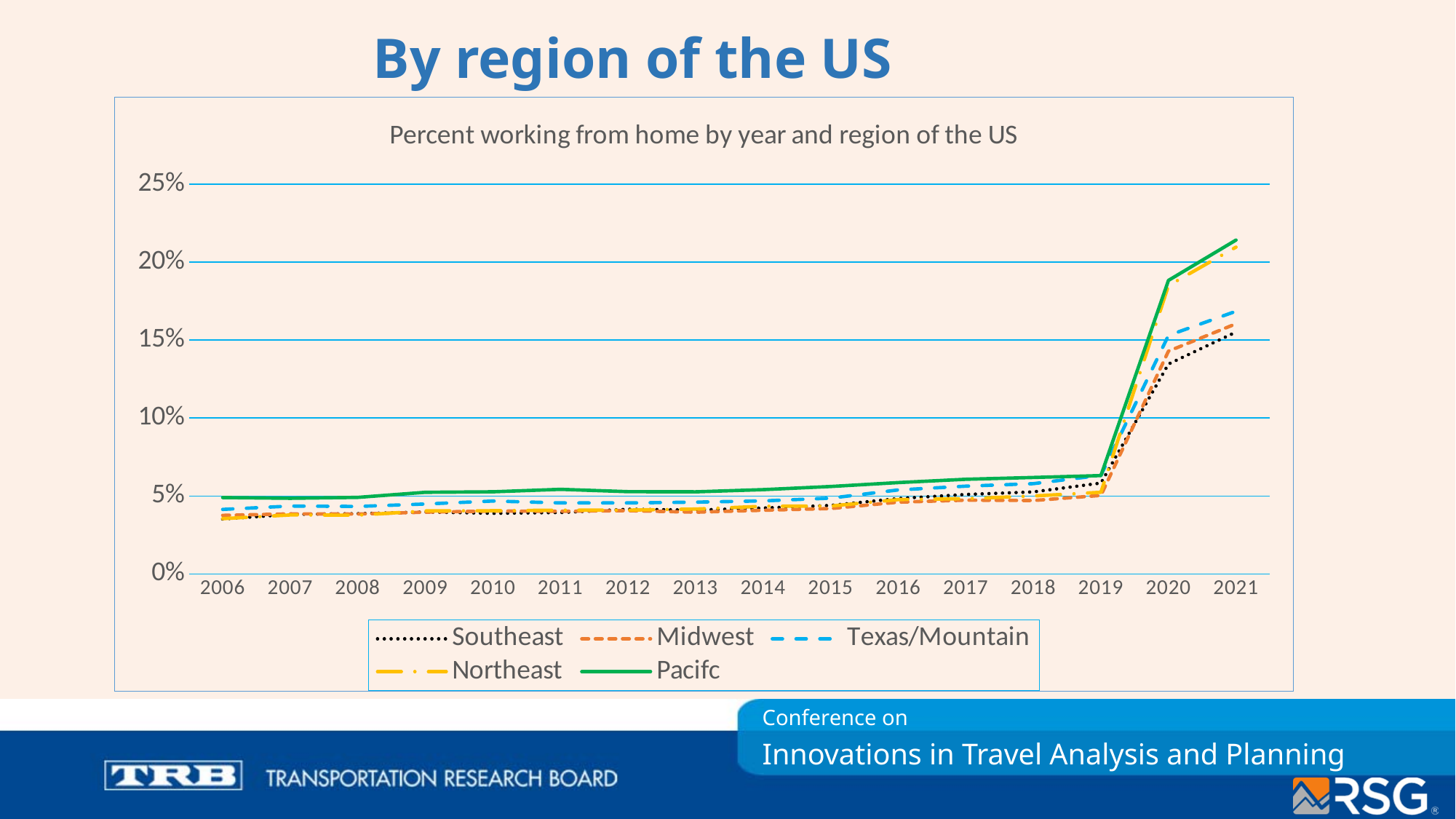
Does the percent working from home for Pacifc rise or fall between 2019 and 2021? rise How many years are shown on the x axis? 16 Is the value for Midwest in 2021 greater or less than 15%? greater Is the value for Texas/Mountain in 2006 greater or less than 5%? less What is the title of the chart? Percent working from home by year and region of the US How many series does the legend list? 5 Is the value for Pacifc in 2021 greater or less than 20%? greater Which region is represented by the solid green line? Pacifc Which region has the lowest percent working from home in 2021? Southeast Which region has the highest percent working from home in 2006? Pacifc What kind of chart is shown on the slide? line chart Which region has the highest percent working from home in 2021? Pacifc